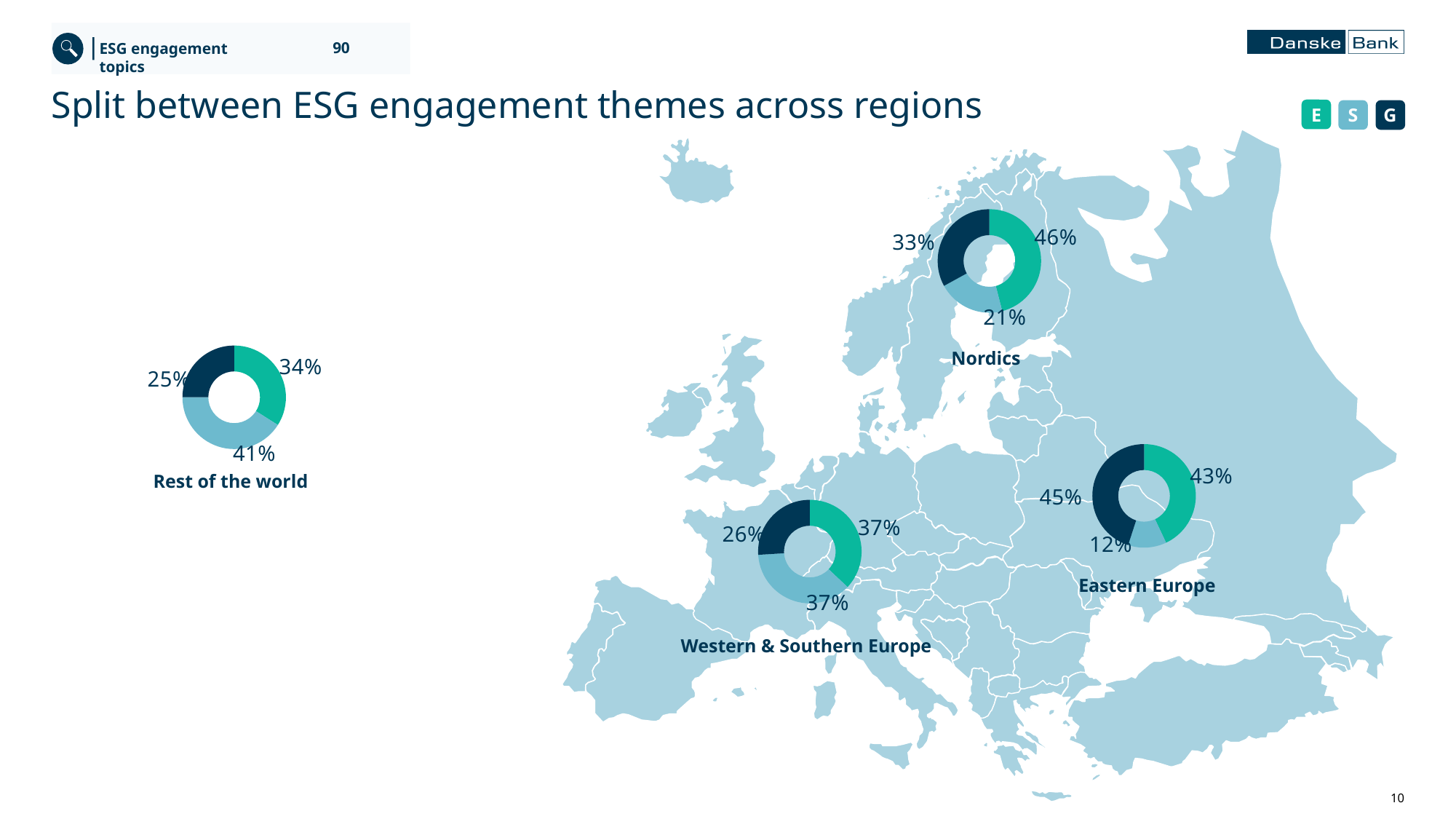
In the Nordics donut chart, which slice is the smallest? The light blue slice (21%) Which is larger: the green slice in the Nordics chart or the green slice in the Eastern Europe chart? Nordics (46%) How many donut charts are shown on the slide? 4 In the Eastern Europe donut chart, what is the value of the light blue slice? 12% What kind of chart is used to show the split for each region? Donut (pie) chart In the Rest of the world donut chart, what is the value of the dark navy slice? 25% In the Nordics donut chart, what is the difference between the green slice and the dark navy slice? 13 percentage points In the Eastern Europe donut chart, which slice is the largest? The dark navy slice (45%) In the Nordics donut chart, what is the value of the green slice? 46% In the Western & Southern Europe donut chart, what is the value of the green slice? 37% In the Rest of the world donut chart, what is the difference between the light blue slice and the dark navy slice? 16 percentage points Which region's chart is placed on the left side of the slide, outside the map? Rest of the world